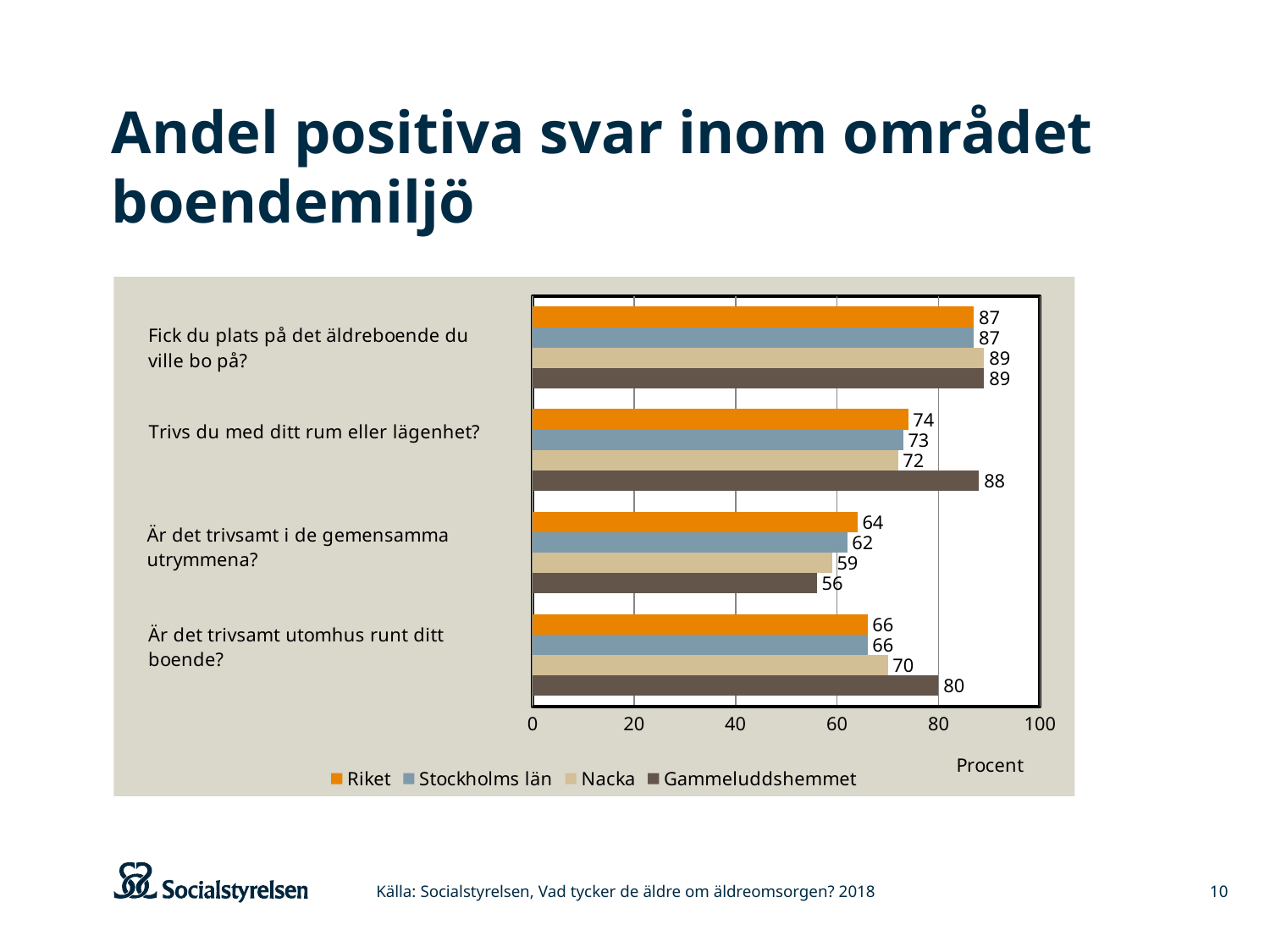
What is the value for Riket on "Är det trivsamt i de gemensamma utrymmena?"? 64 Which series has the lowest value on "Är det trivsamt i de gemensamma utrymmena?"? Gammeluddshemmet How many questions (categories) are shown on the chart? 4 What is the value for Gammeluddshemmet on "Trivs du med ditt rum eller lägenhet?"? 88 What is the value for Nacka on "Är det trivsamt utomhus runt ditt boende?"? 70 Which is larger on "Är det trivsamt utomhus runt ditt boende?": Riket or Gammeluddshemmet? Gammeluddshemmet What kind of chart is shown on the slide? Bar chart Is the value for Stockholms län on "Fick du plats på det äldreboende du ville bo på?" greater or less than 80? greater What is the difference between Gammeluddshemmet and Nacka on "Trivs du med ditt rum eller lägenhet?"? 16 What is the label on the horizontal axis of the chart? Procent How many series does the legend list? 4 Which series has the highest value on "Är det trivsamt utomhus runt ditt boende?"? Gammeluddshemmet